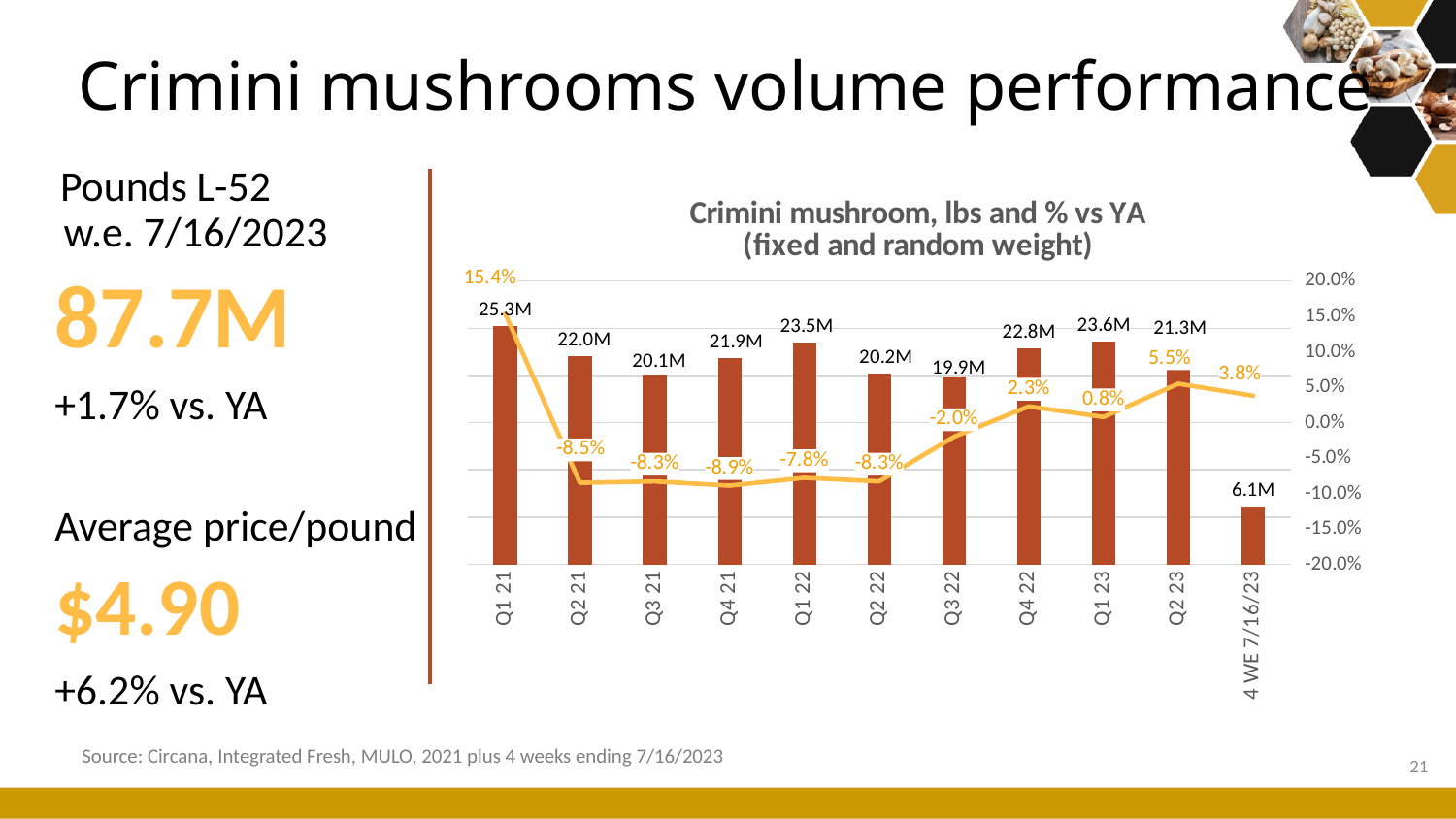
Which has the larger volume in pounds, Q4 22 or Q1 22? Q1 22 What is the % vs YA value for Q2 23? 5.5% What is the difference in pounds between Q1 23 and Q2 23? 2.3M Which quarter has the highest volume in pounds? Q1 21 What is the % vs YA value for Q4 21? -8.9% What is the title of the chart? Crimini mushroom, lbs and % vs YA (fixed and random weight) What is the volume in pounds for Q1 21? 25.3M Is the % vs YA value for Q3 22 greater or less than 0.0%? less What kind of chart is used to show the pounds values? bar chart Which period has the lowest % vs YA value? Q4 21 How many periods are shown on the x axis? 11 What is the volume in pounds for the 4 WE 7/16/23 period? 6.1M